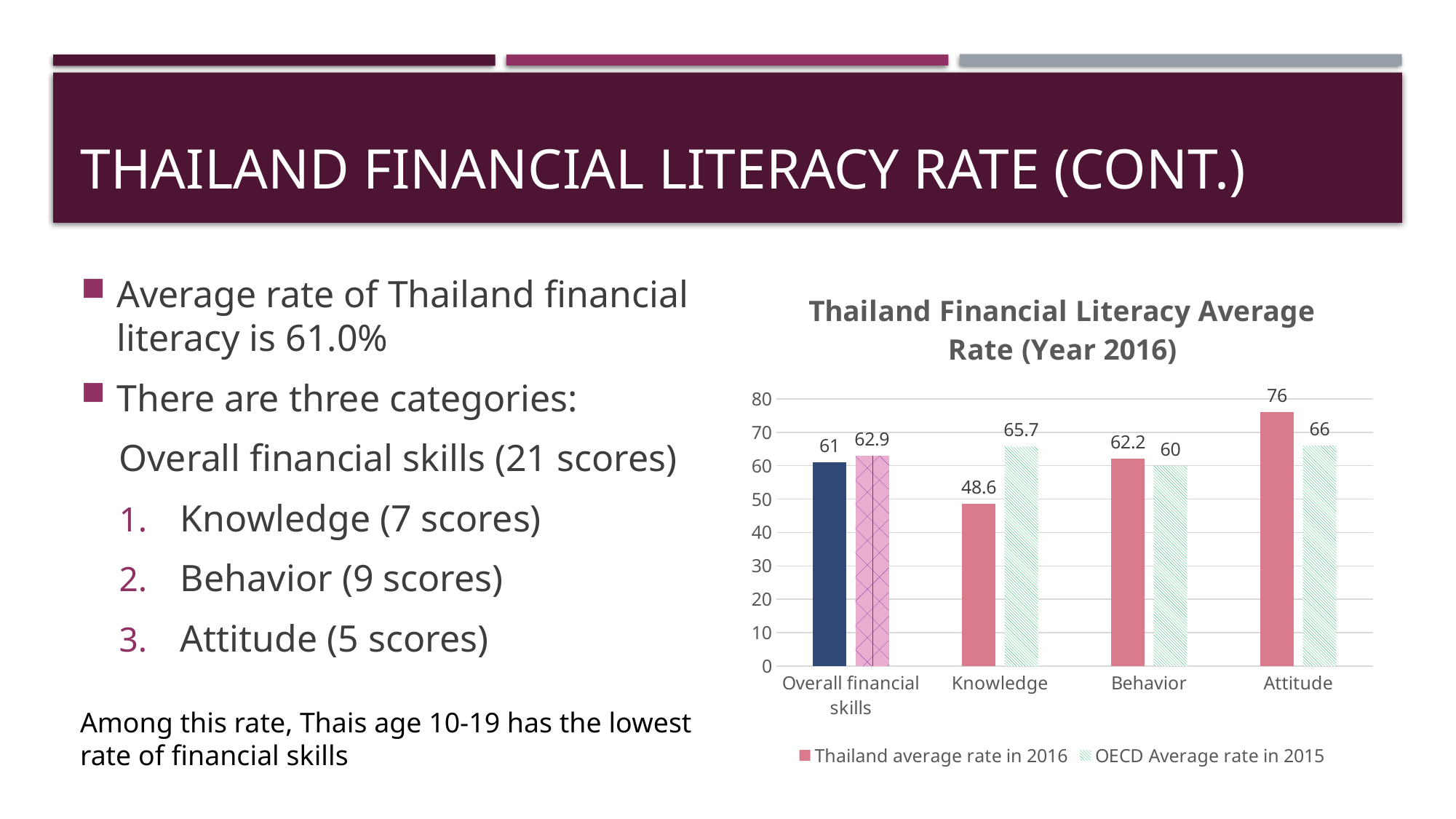
Which category has the lowest Thailand average rate in 2016? Knowledge What is the OECD average rate in 2015 for Behavior? 60 What is the OECD average rate in 2015 for Attitude? 66 How many categories are shown on the x axis of the chart? 4 Which category has the highest Thailand average rate in 2016? Attitude For Behavior, which is larger: the Thailand average rate in 2016 or the OECD average rate in 2015? Thailand average rate in 2016 What is the Thailand average rate in 2016 for Knowledge? 48.6 What is the title of the chart? Thailand Financial Literacy Average Rate (Year 2016) What is the Thailand average rate in 2016 for Overall financial skills? 61 How many series does the chart legend list? 2 What kind of chart is shown on the slide? Bar chart What is the difference between the OECD average rate in 2015 and the Thailand average rate in 2016 for Knowledge? 17.1